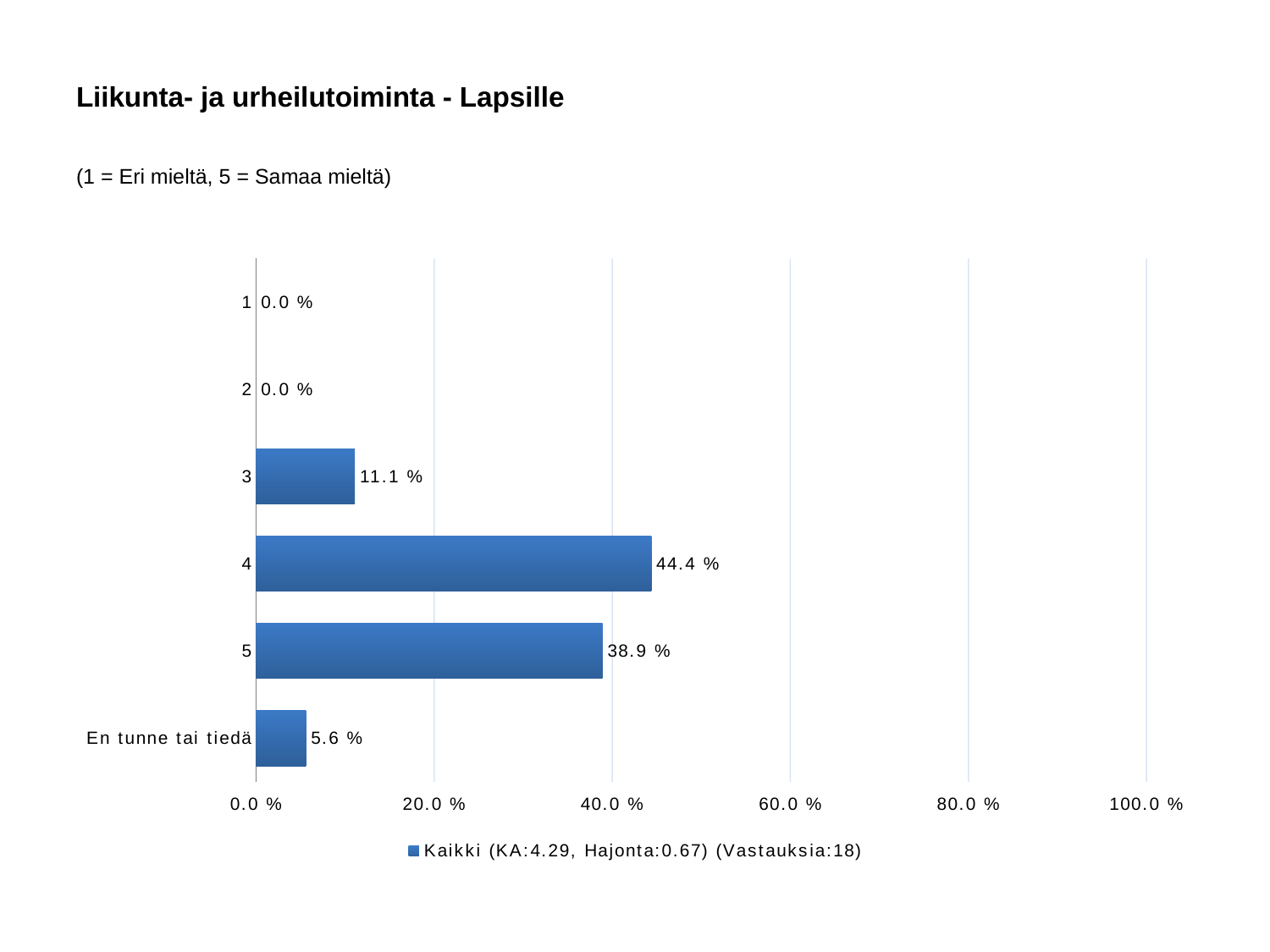
Which is larger, the value for category 3 or the value for 'En tunne tai tiedä'? 3 How many categories are shown on the chart? 6 What is the value for 'En tunne tai tiedä'? 5.6 % What is the difference between the values for category 4 and category 5? 5.5 % What is the value for category 3? 11.1 % Which category has the highest value? 4 Is the value for category 4 greater or less than 40.0 %? greater What is the title of the slide? Liikunta- ja urheilutoiminta - Lapsille What is the value for category 4? 44.4 % How many series does the legend list? 1 What is the value for category 5? 38.9 % What kind of chart is shown on the slide? bar chart